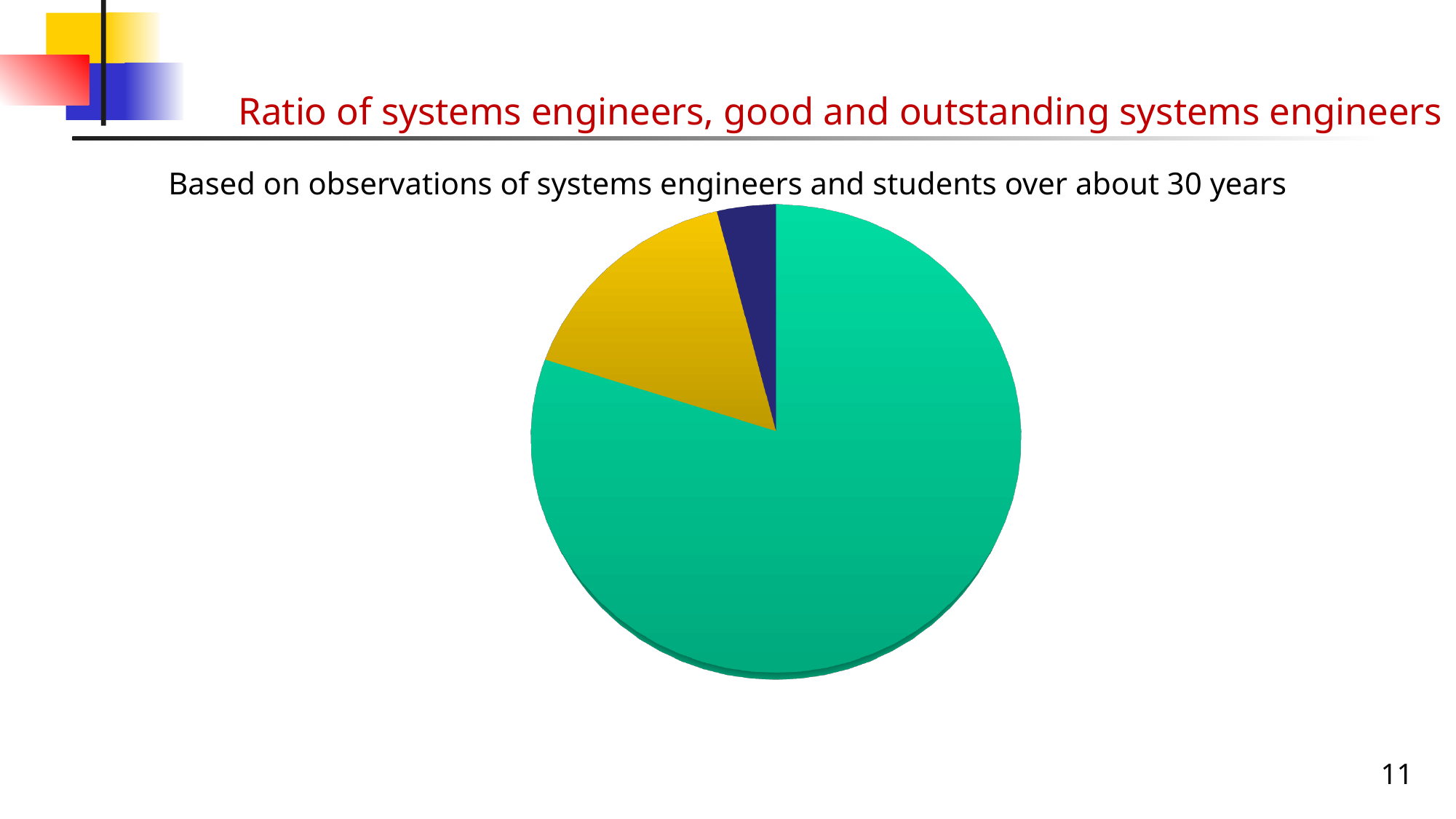
Which colour slice is the smallest in the pie chart? dark blue Which colour slice is the largest in the pie chart? green What is the title of the slide containing the pie chart? Ratio of systems engineers, good and outstanding systems engineers Which is larger in the pie chart, the green slice or the yellow slice? green What kind of chart is shown on the slide? pie chart How many slices does the pie chart have? 3 Which is larger in the pie chart, the yellow slice or the dark blue slice? yellow Does the pie chart display a legend? No